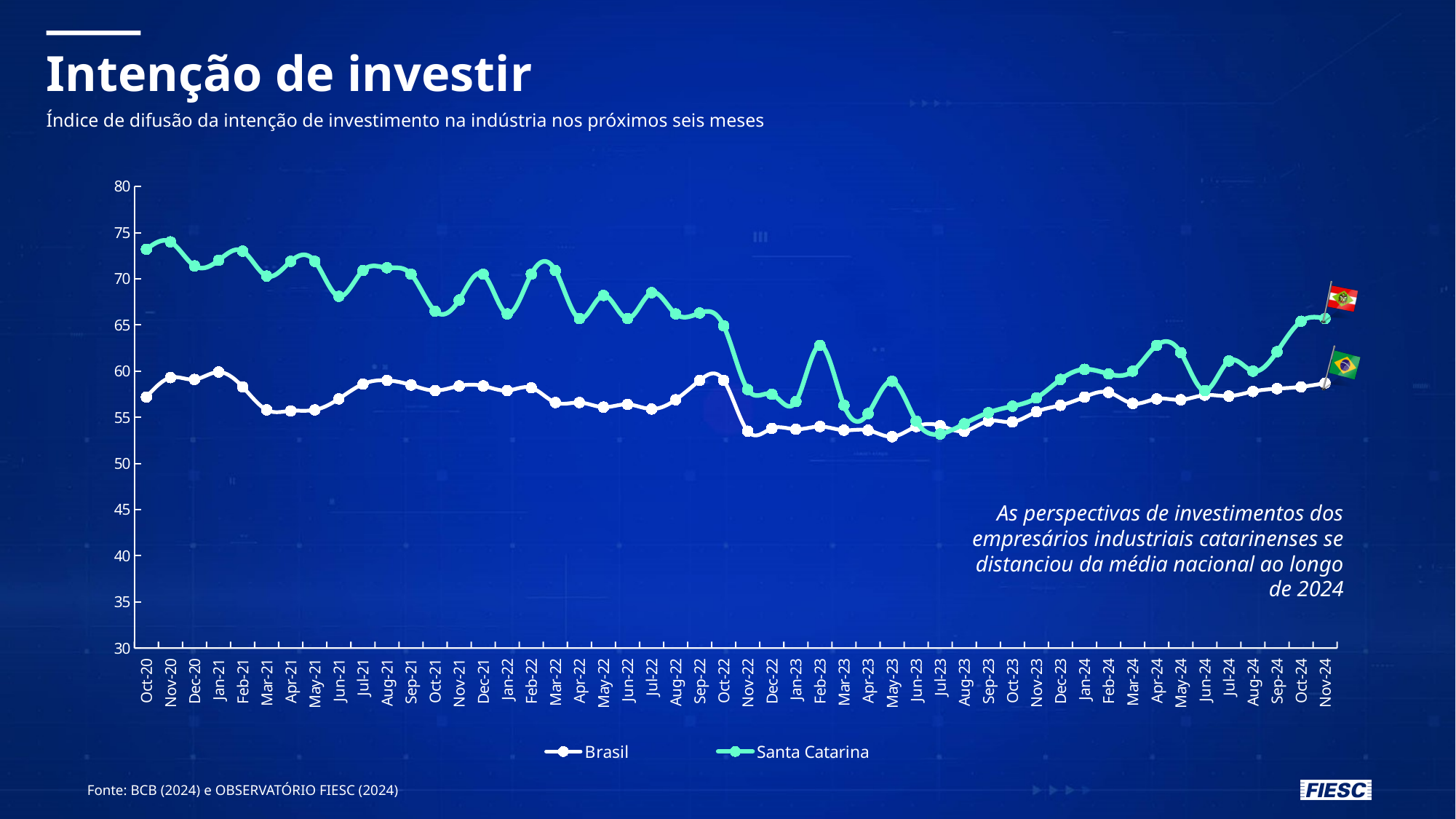
Does the Santa Catarina series generally rise or fall from Jul-23 to Nov-24? Rise Which series has the higher value in Nov-24, Brasil or Santa Catarina? Santa Catarina Is the value for Santa Catarina in Feb-23 greater or less than 60? greater Is the value for Brasil in Nov-22 greater or less than 55? less What kind of chart is shown on the slide? Line chart Is the value for Santa Catarina in Oct-20 greater or less than 70? greater In which month does the Santa Catarina series reach its lowest value? Jul-23 How many monthly points are plotted along the x axis, from Oct-20 to Nov-24? 50 Which two series are shown in the legend? Brasil and Santa Catarina How many series does the legend list? 2 Which series has the higher value in Oct-20, Brasil or Santa Catarina? Santa Catarina